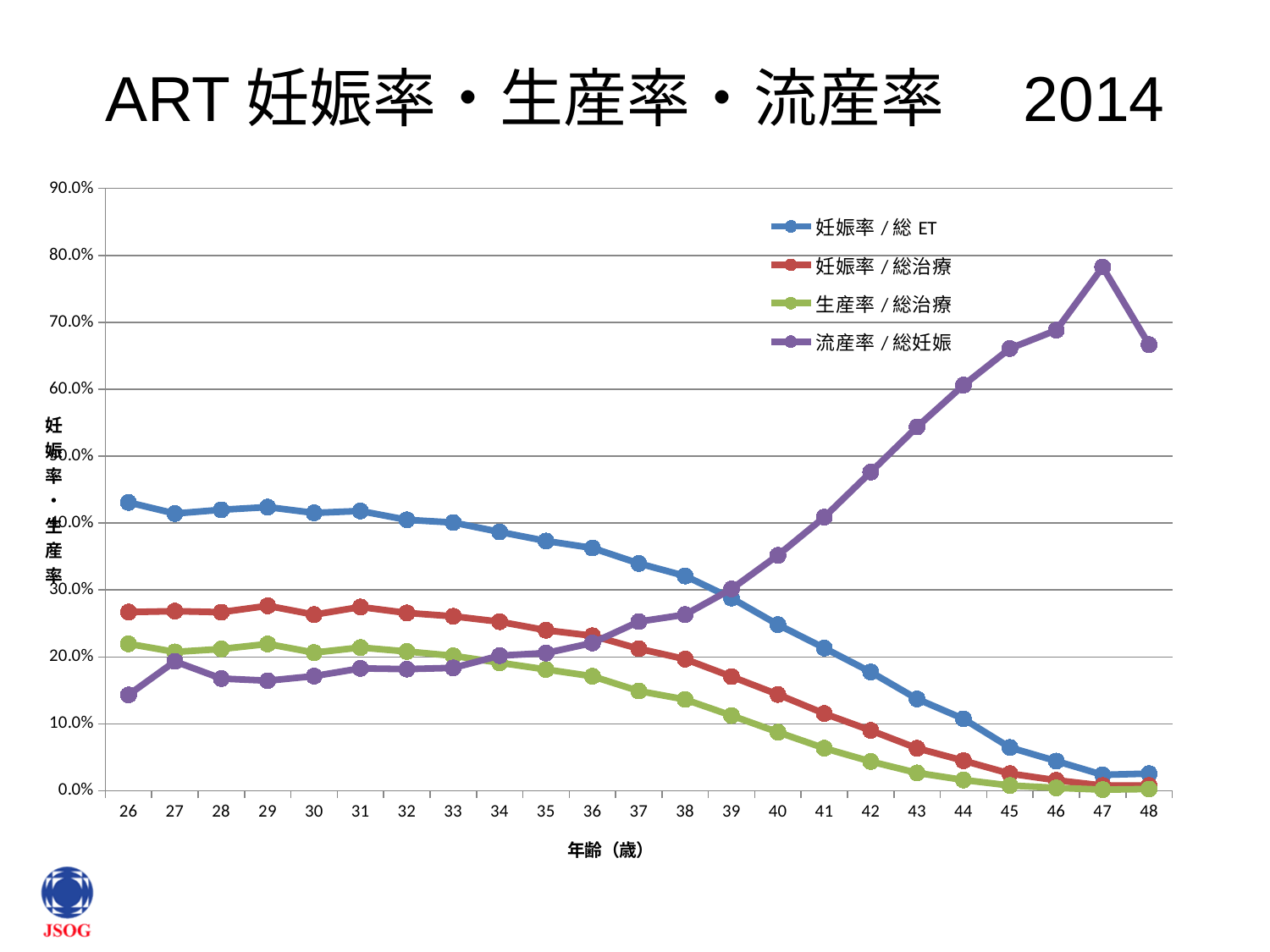
At which age is 流産率 / 総妊娠 highest? 47 At age 30, which is higher: 妊娠率 / 総 ET or 流産率 / 総妊娠? 妊娠率 / 総 ET How many series does the legend list? 4 How many age categories are plotted along the x axis? 23 Does the 流産率 / 総妊娠 series rise or fall as age increases? rise Does the 妊娠率 / 総 ET series rise or fall as age increases? fall At age 45, which is higher: 流産率 / 総妊娠 or 生産率 / 総治療? 流産率 / 総妊娠 Is the value of 流産率 / 総妊娠 at age 47 greater or less than 70.0%? greater What is the title of the slide? ART 妊娠率・生産率・流産率 2014 What kind of chart is shown on the slide? line chart Is the value of 妊娠率 / 総 ET at age 26 greater or less than 40.0%? greater Is the value of 生産率 / 総治療 at age 40 greater or less than 10.0%? less